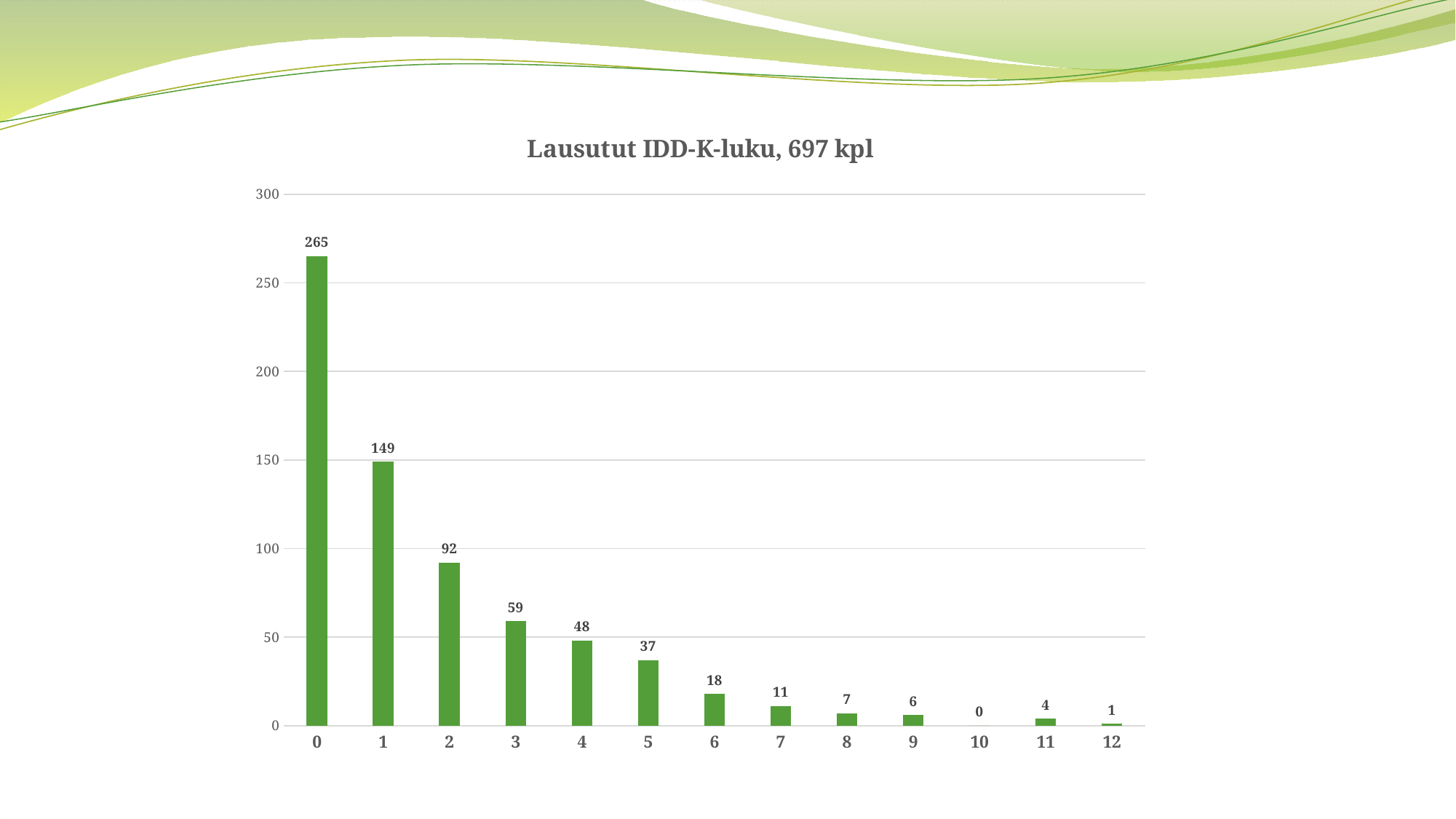
What is the value for category 11? 4 Do the values generally rise or fall from category 0 to category 9? fall What is the value for category 0? 265 What is the title of the chart? Lausutut IDD-K-luku, 697 kpl What kind of chart is shown on the slide? bar chart Which category has the highest value? 0 Which is larger, the value for category 4 or the value for category 5? 4 What is the difference between the values for category 0 and category 1? 116 Which category has the lowest value? 10 What is the value for category 3? 59 How many categories are shown on the x axis? 13 Is the value for category 2 greater or less than 100? less